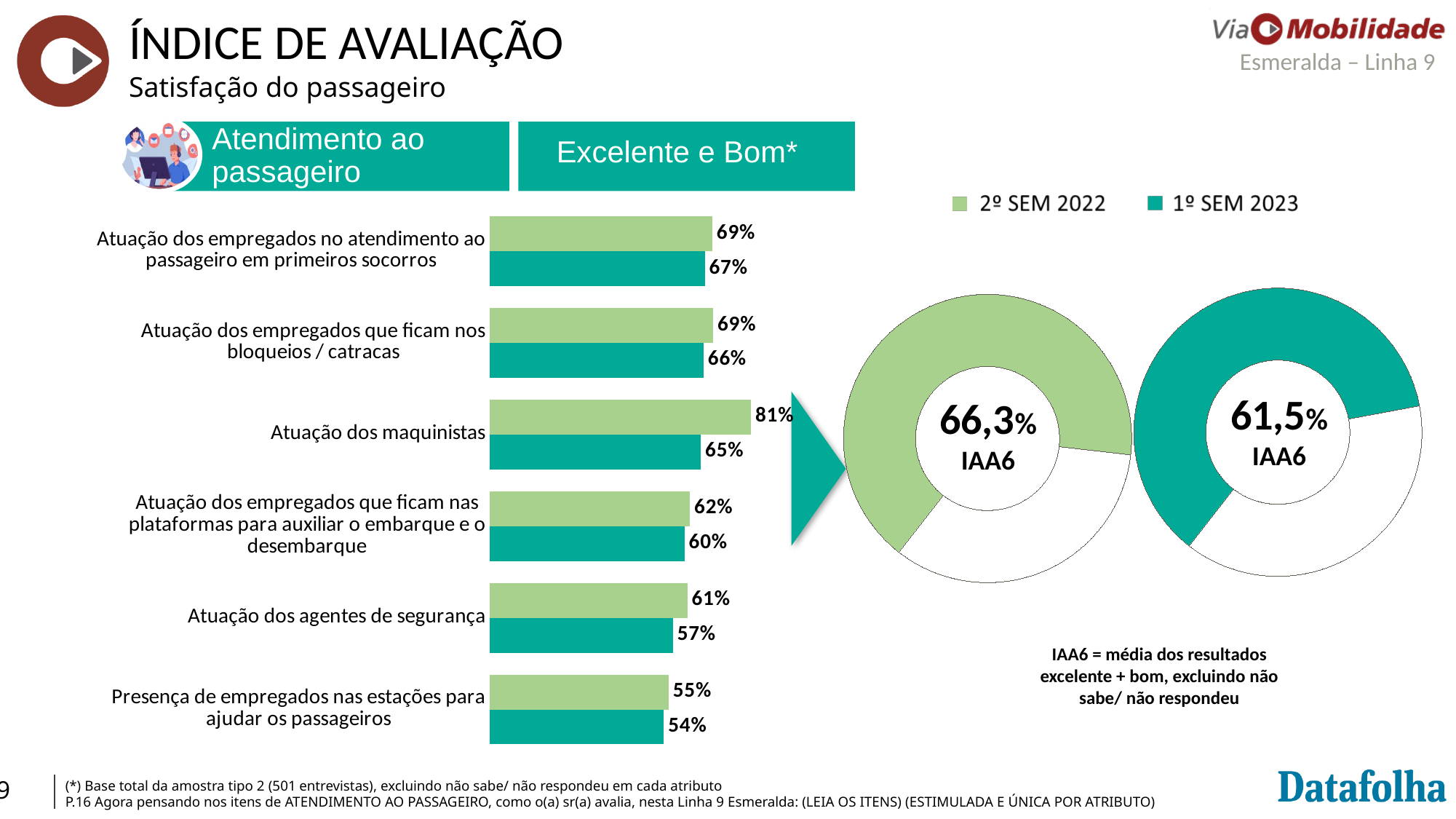
In the bar chart, which category has the highest 2º SEM 2022 value? Atuação dos maquinistas How many categories does the bar chart show? 6 In the bar chart, what is the 1º SEM 2023 value for 'Presença de empregados nas estações para ajudar os passageiros'? 54% What is the difference between the IAA6 values shown in the two donut charts (66,3% and 61,5%)? 4,8% In the bar chart, what is the 1º SEM 2023 value for 'Atuação dos maquinistas'? 65% What kind of chart is used to show the 'Excelente e Bom*' results by category? Bar chart In the bar chart, which category has the lowest 1º SEM 2023 value? Presença de empregados nas estações para ajudar os passageiros In the bar chart, what is the 2º SEM 2022 value for 'Atuação dos agentes de segurança'? 61% In the bar chart, what is the difference between the 2º SEM 2022 and 1º SEM 2023 values for 'Atuação dos maquinistas'? 16% In the left donut chart, what is the IAA6 value for 2º SEM 2022? 66,3% How many series does the legend of the bar chart list? 2 In the bar chart, which is larger for 'Atuação dos empregados que ficam nos bloqueios / catracas': the 2º SEM 2022 value or the 1º SEM 2023 value? 2º SEM 2022